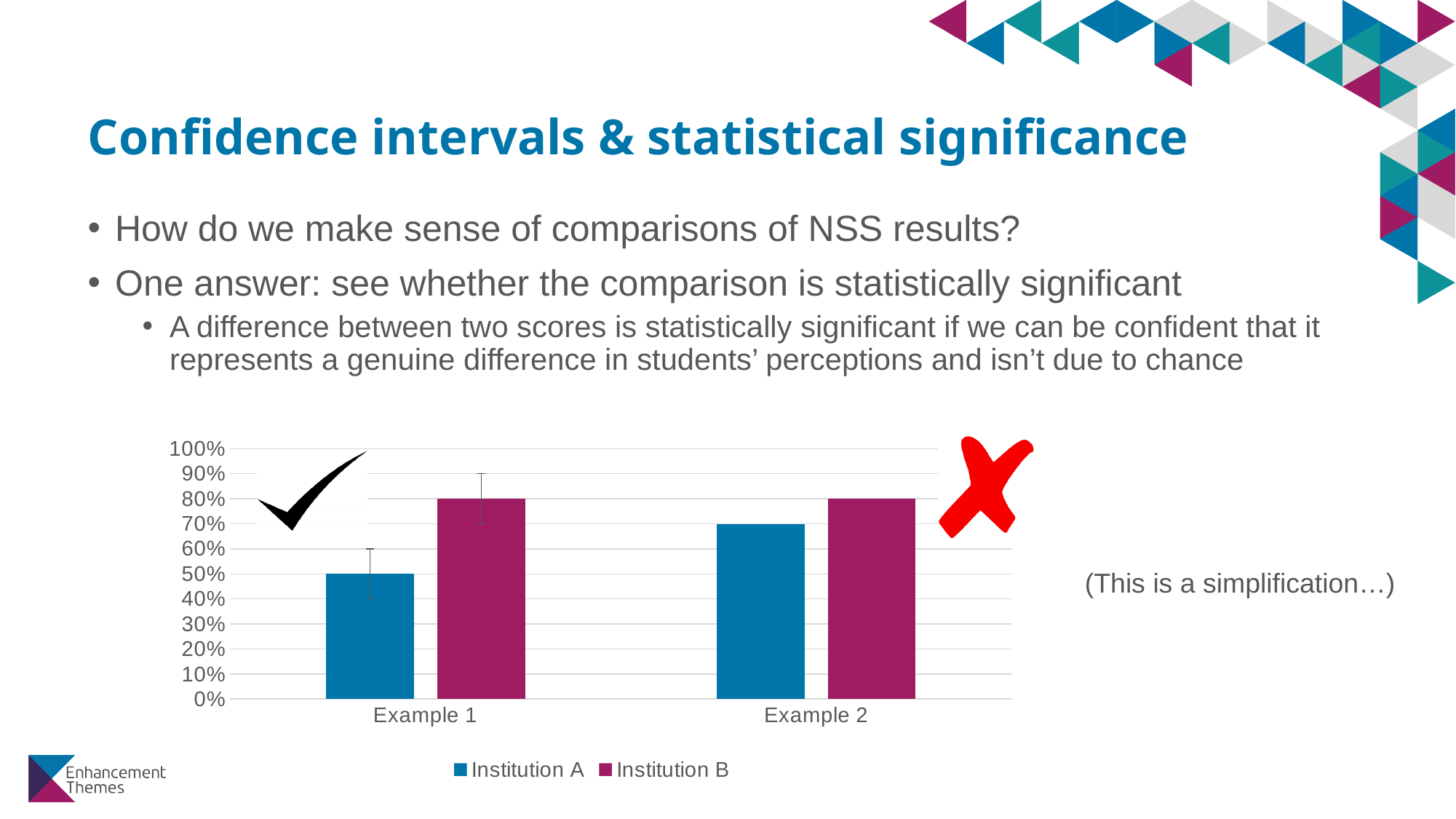
What is the difference between Institution B and Institution A in Example 1? 30% What is the difference between Institution B and Institution A in Example 2? 10% What is the value for Institution A in Example 2? 70% What kind of chart is shown on the slide? bar chart How many categories are shown on the x axis? 2 What is the value for Institution B in Example 1? 80% In Example 1, which institution has the higher value? Institution B How many series does the legend list? 2 What is the value for Institution B in Example 2? 80% What is the value for Institution A in Example 1? 50% Which category has the lowest value for Institution A? Example 1 Which series is shown in blue in the legend? Institution A